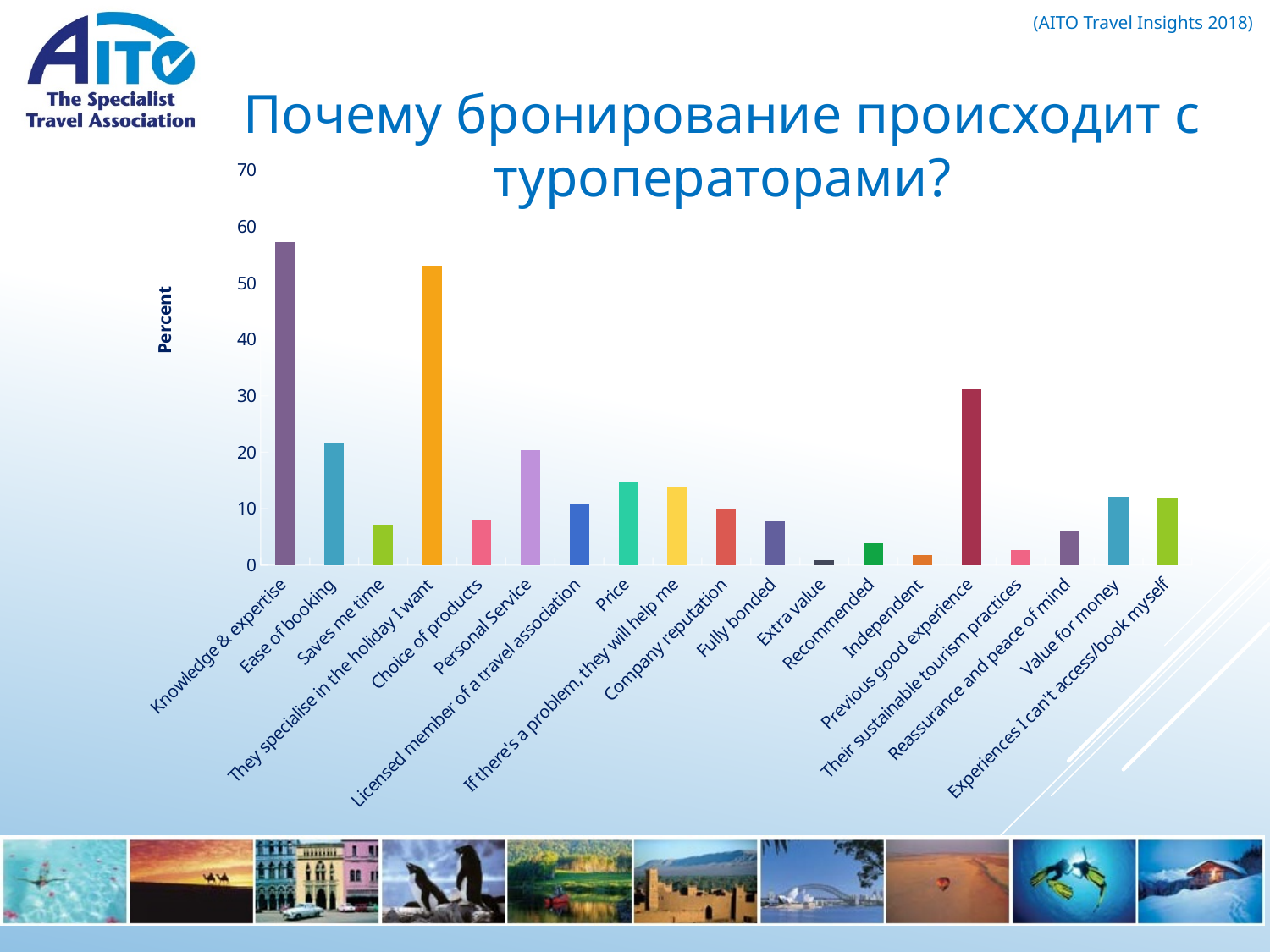
Which category has the highest value on the chart? Knowledge & expertise Which is larger, the value for Personal Service or the value for Saves me time? Personal Service Is the value for Previous good experience greater or less than 20? greater Is the value for Knowledge & expertise greater or less than 50? greater What is the label on the vertical axis of the chart? Percent Is the value for Personal Service greater or less than 10? greater How many categories (reasons) are plotted on the chart? 19 What kind of chart is shown on the slide? bar chart Which is larger, the value for Knowledge & expertise or the value for Previous good experience? Knowledge & expertise Which is larger, the value for Price or the value for Extra value? Price